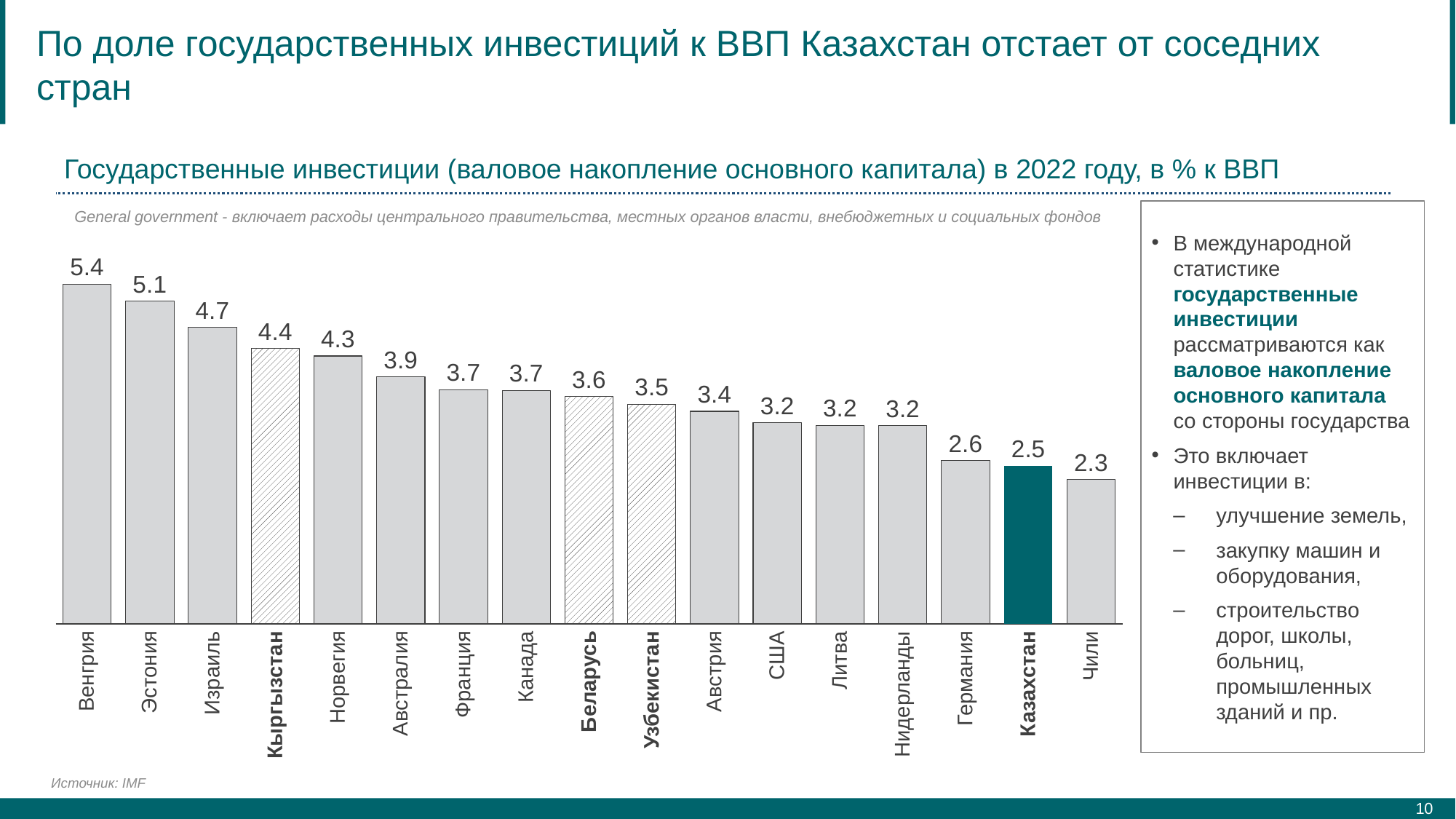
Which country has the lowest value? Чили What is the value for Казахстан? 2.5 What is the value for Узбекистан? 3.5 How many countries are shown in the chart? 17 Which country has the highest value? Венгрия Which country's bar is highlighted in dark teal? Казахстан Do the values rise or fall from left to right along the x axis? Fall What is the difference between the values for Венгрия and Казахстан? 2.9 What is the value for Кыргызстан? 4.4 Which is larger, the value for Беларусь or the value for Германия? Беларусь What is the difference between the values for Кыргызстан and Казахстан? 1.9 What kind of chart is shown on the slide? Bar chart